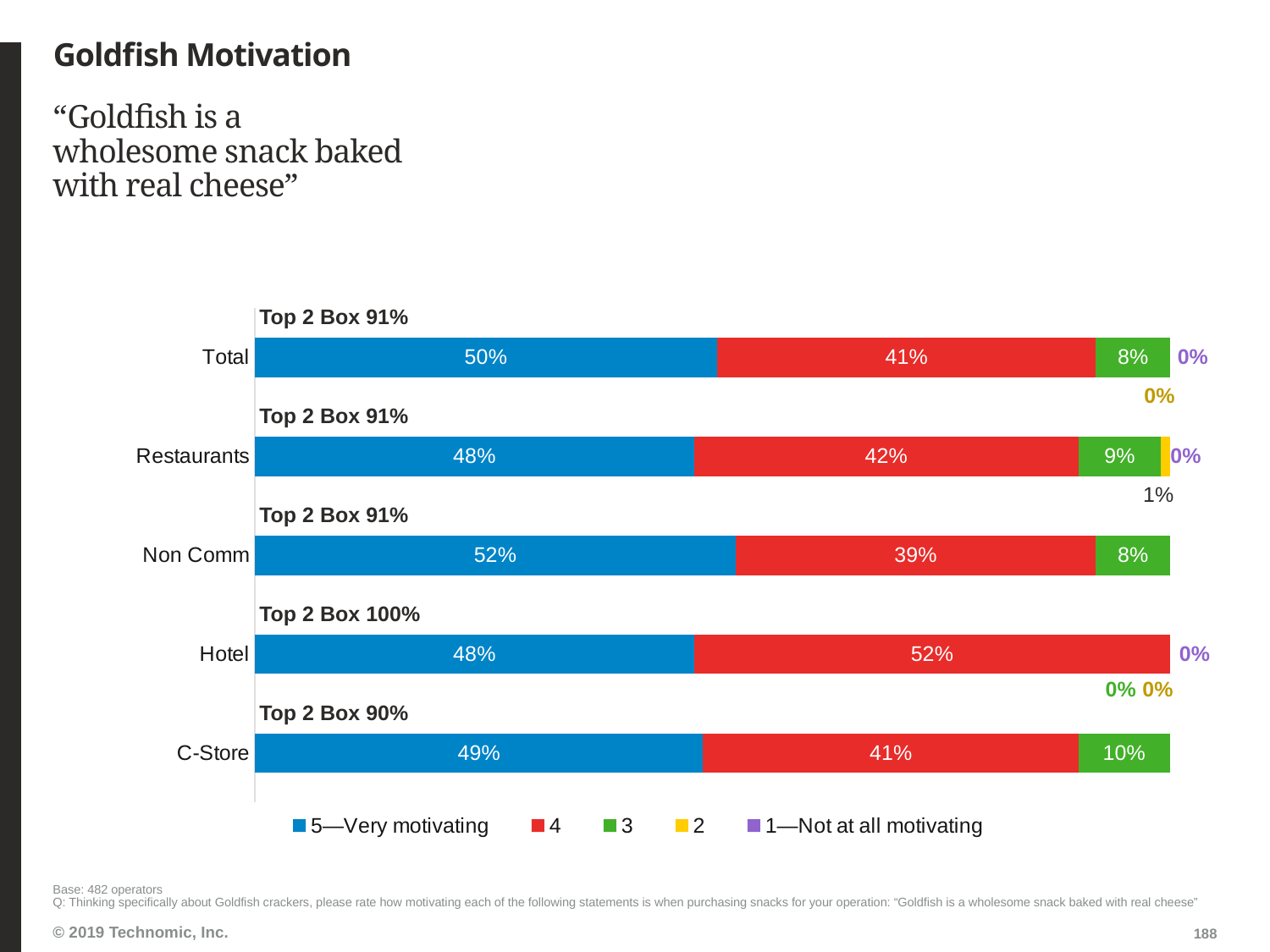
What percentage of C-Store respondents gave a rating of 3? 10% How many series does the legend list? 5 What type of chart is shown on the slide? stacked bar chart What percentage of Hotel respondents gave a rating of 4? 52% Which category has the lowest Top 2 Box value? C-Store What percentage of Total respondents rated the statement 5—Very motivating? 50% Which category has the highest share of 5—Very motivating ratings? Non Comm Which category shows a 1% share for the rating of 2? Restaurants Which is larger for Hotel: the share rating 5—Very motivating or the share rating 4? 4 What is the Top 2 Box value shown for Hotel? 100% What is the difference between the 5—Very motivating share for Non Comm and for Restaurants? 4% How many categories (operator segments) are plotted in the chart? 5